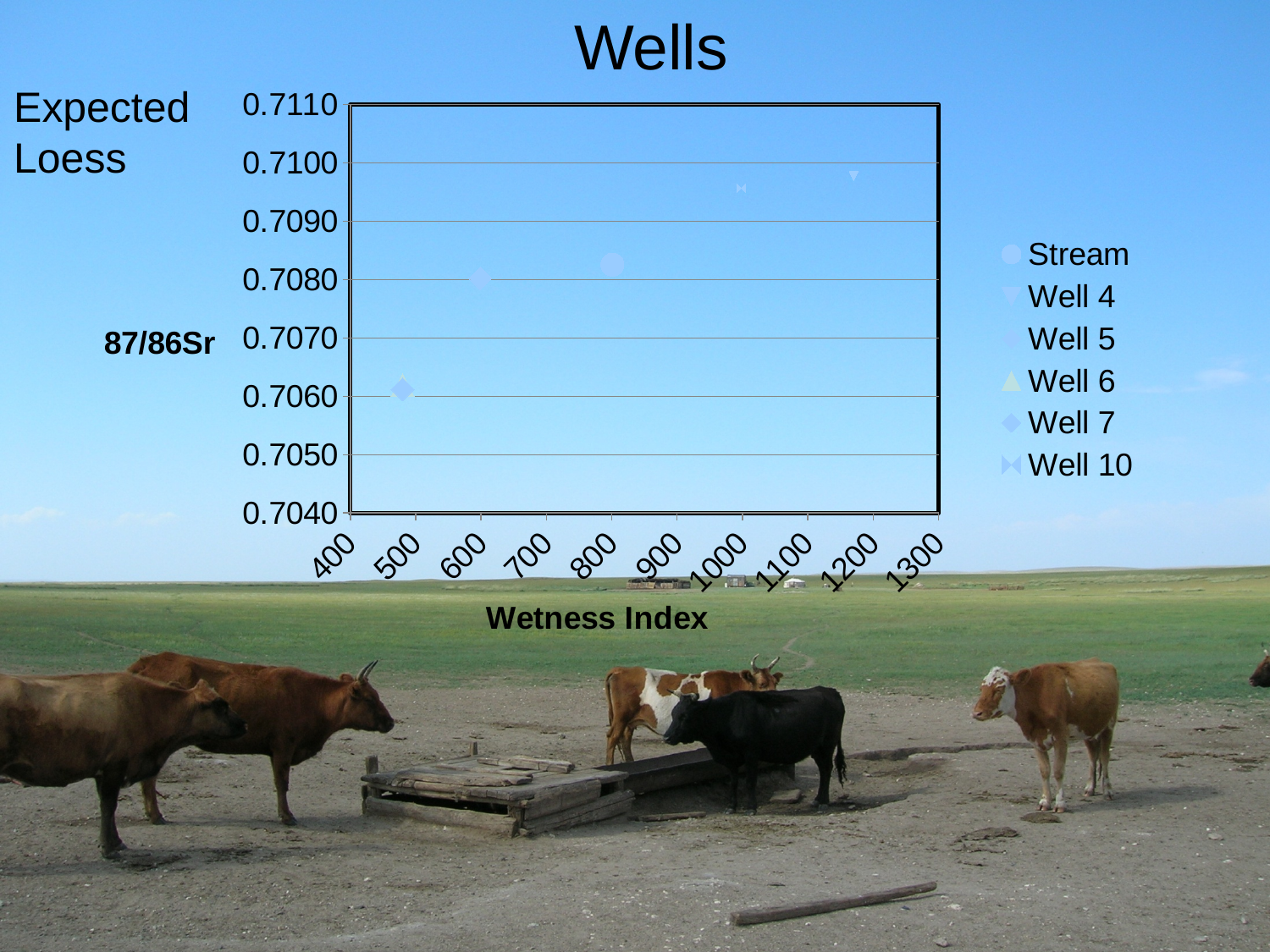
Is the 87/86Sr value for Well 10 greater or less than 0.7090? greater Which has the higher 87/86Sr value, Stream or Well 7? Stream How many series does the legend list? 6 Is the 87/86Sr value for Well 7 greater or less than 0.7070? less Do the 87/86Sr values generally rise or fall as the Wetness Index increases? rise Which has the higher 87/86Sr value, Well 4 or Well 7? Well 4 Is the 87/86Sr value for Well 7 greater or less than 0.7050? greater What is the title of the chart? Wells What kind of chart is shown on the slide? scatter chart What is the x-axis title of the chart? Wetness Index